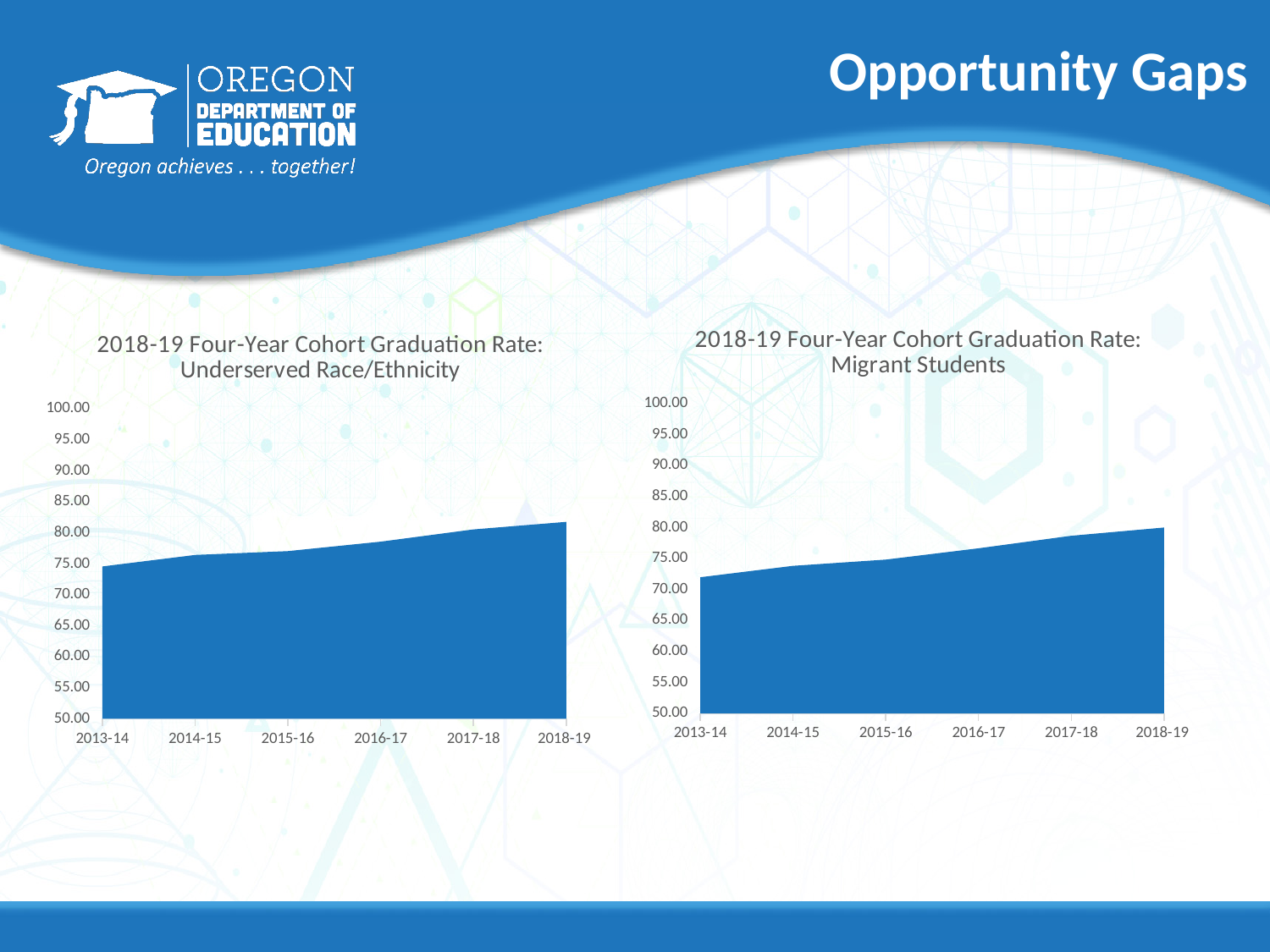
In the left chart (Underserved Race/Ethnicity), is the value for 2013-14 greater or less than 70.00? greater In the right chart (Migrant Students), which school year has the lowest graduation rate? 2013-14 In the left chart (Underserved Race/Ethnicity), which school year has the highest graduation rate? 2018-19 What kind of chart is the left chart, '2018-19 Four-Year Cohort Graduation Rate: Underserved Race/Ethnicity'? Area chart How many school years are shown on the x axis of the right chart, '2018-19 Four-Year Cohort Graduation Rate: Migrant Students'? 6 In the right chart (Migrant Students), is the value for 2013-14 greater or less than 75.00? less In the left chart (Underserved Race/Ethnicity), is the value for 2018-19 greater or less than 80.00? greater In the right chart (Migrant Students), which is larger, the value for 2018-19 or the value for 2013-14? 2018-19 In the left chart (Underserved Race/Ethnicity), do the graduation rates rise or fall from 2013-14 to 2018-19? Rise In the right chart (Migrant Students), do the graduation rates rise or fall from 2013-14 to 2018-19? Rise What is the title of the chart on the right side of the slide? 2018-19 Four-Year Cohort Graduation Rate: Migrant Students